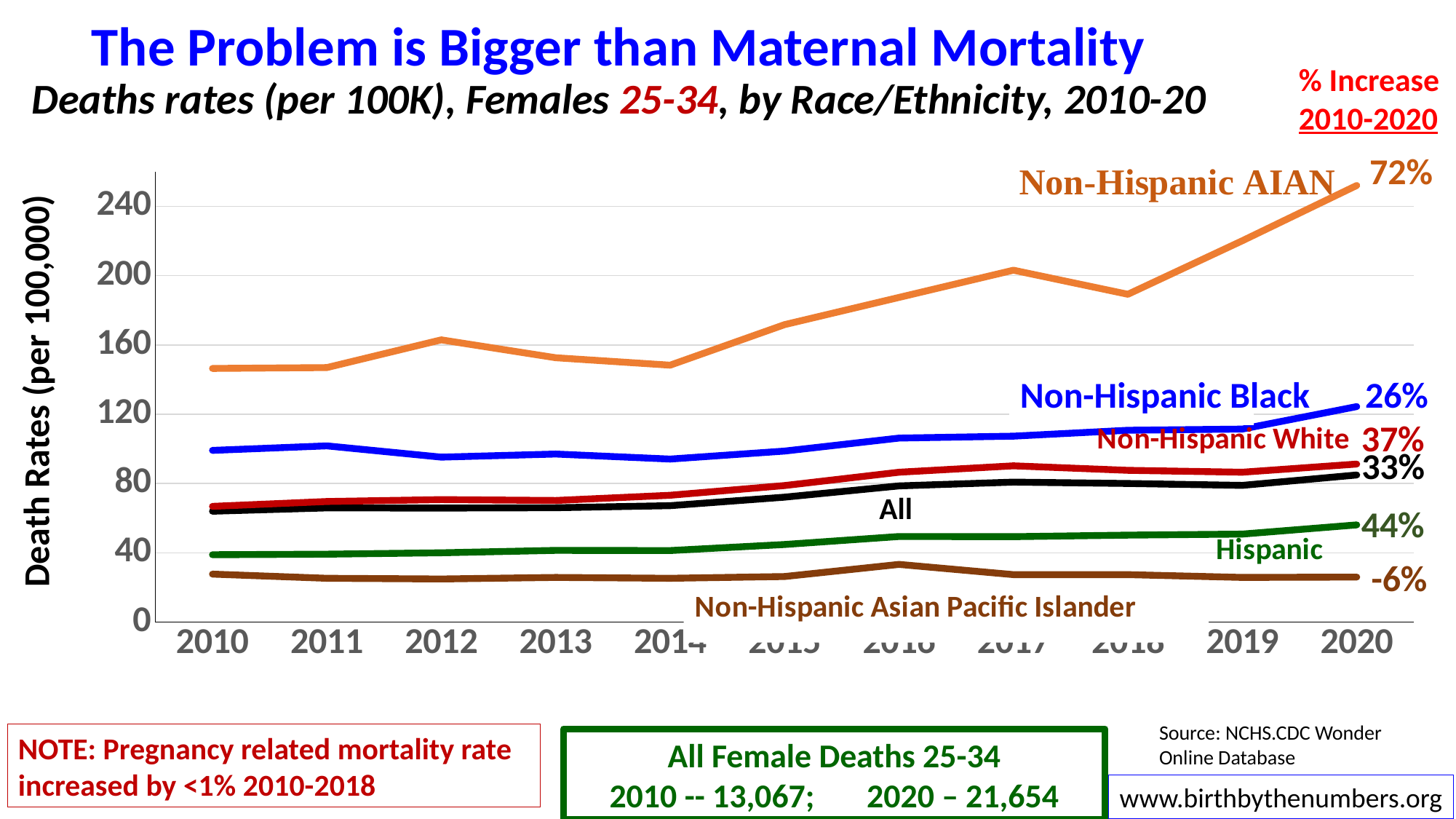
What is the % increase 2010-2020 shown for Hispanic? 44% Is the death rate for Non-Hispanic Asian Pacific Islander in 2020 greater or less than 40? less How many race/ethnicity series (lines) are plotted on the chart? 6 What is the % increase 2010-2020 shown for Non-Hispanic AIAN? 72% Does the Non-Hispanic AIAN death rate rise or fall from 2014 to 2020? rise What kind of chart is shown on the slide? line chart In 2020, which line is higher: Non-Hispanic Black or Non-Hispanic White? Non-Hispanic Black Which group has the lowest % increase 2010-2020? Non-Hispanic Asian Pacific Islander Is the death rate for Non-Hispanic AIAN in 2020 greater or less than 200? greater Which group has the highest % increase 2010-2020? Non-Hispanic AIAN What is the y-axis label of the chart? Death Rates (per 100,000) What is the % increase 2010-2020 shown for Non-Hispanic Asian Pacific Islander? -6%